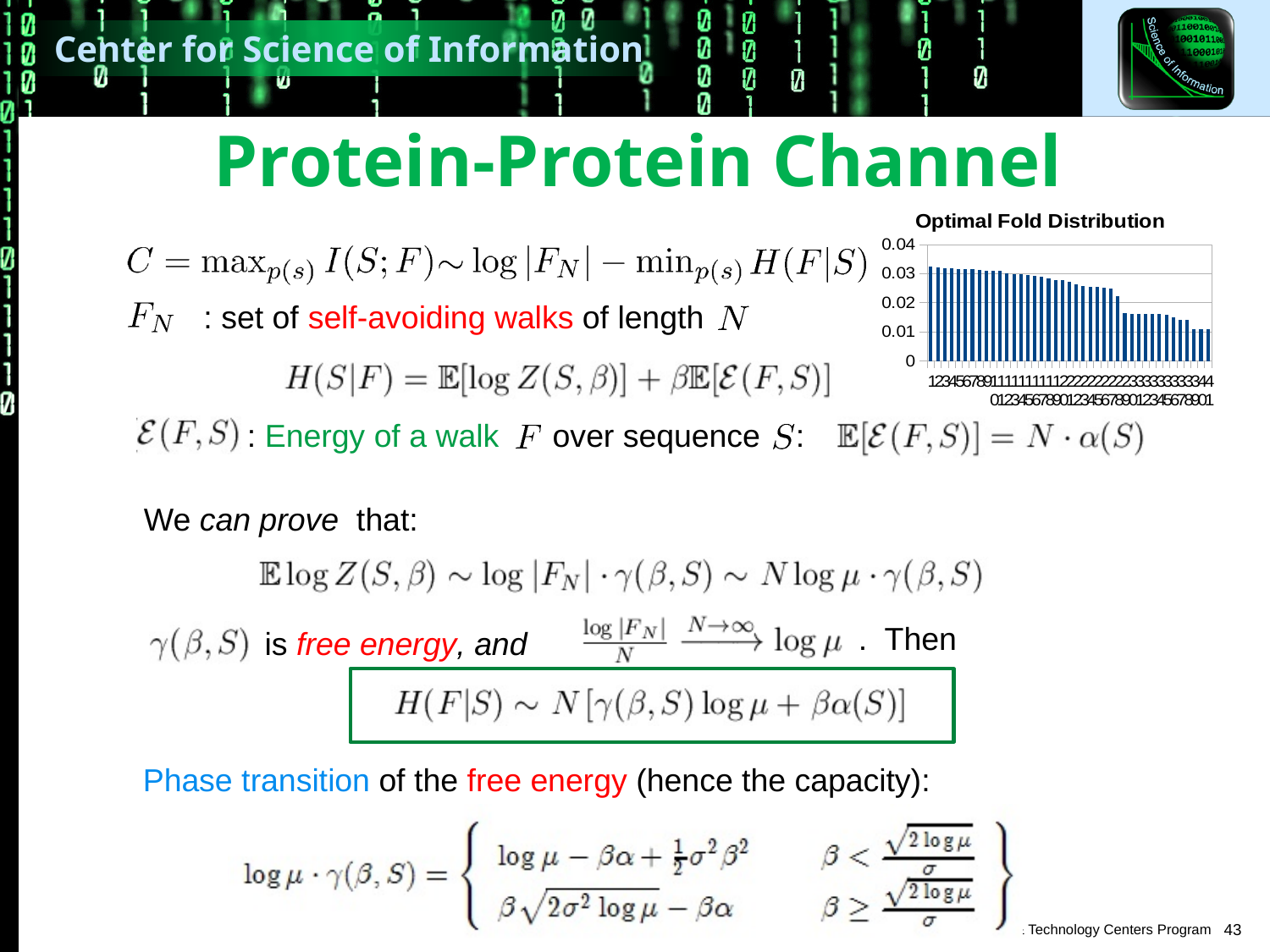
In the Optimal Fold Distribution chart, is the value of the last (rightmost) bar greater or less than 0.02? less What kind of chart is shown on the slide? bar chart What is the highest value shown on the y axis of the Optimal Fold Distribution chart? 0.04 In the Optimal Fold Distribution chart, is the value of the first (leftmost) bar greater or less than 0.04? less In the Optimal Fold Distribution chart, which bar is larger: the leftmost bar or the rightmost bar? the leftmost bar In the Optimal Fold Distribution chart, is the value of the first (leftmost) bar greater or less than 0.02? greater What is the title of the chart on the slide? Optimal Fold Distribution Do the bar values in the Optimal Fold Distribution chart rise or fall from left to right along the x axis? fall